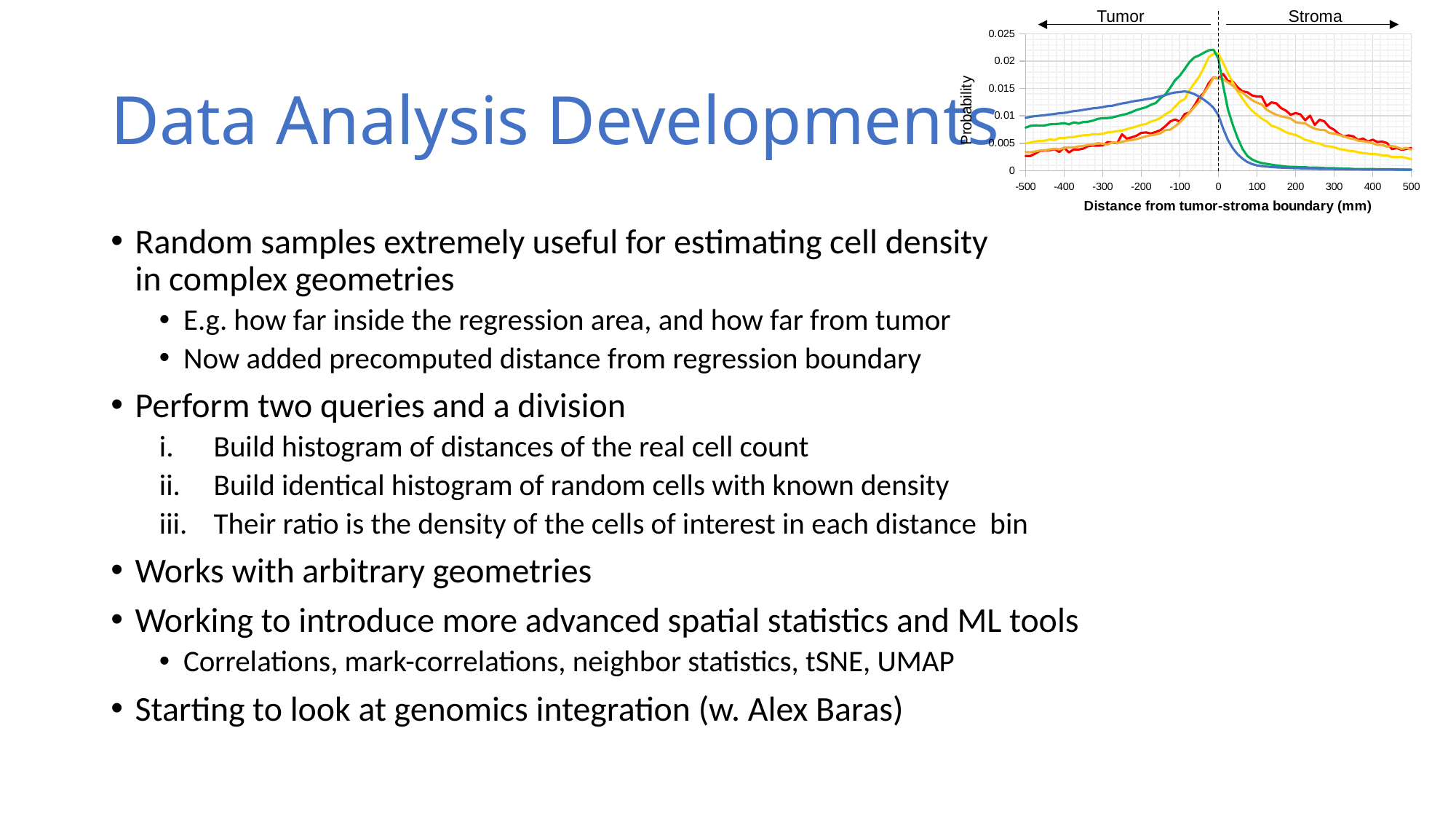
What kind of chart is shown in the top right of the slide? line chart What is the x-axis title of the chart? Distance from tumor-stroma boundary (mm) Is the value of the blue line at a distance of 500 greater or less than 0.005? less Is the value of the green line at a distance of -500 greater or less than 0.005? greater Is the value of the blue line at a distance of -500 greater or less than 0.005? greater At a distance of 500, which line is higher, the red line or the blue line? red line How many lines are plotted on the chart? 5 What is the y-axis title of the chart? Probability Does the blue line rise or fall as the distance goes from 0 to 500? fall Does the green line rise or fall as the distance goes from -500 to 0? rise